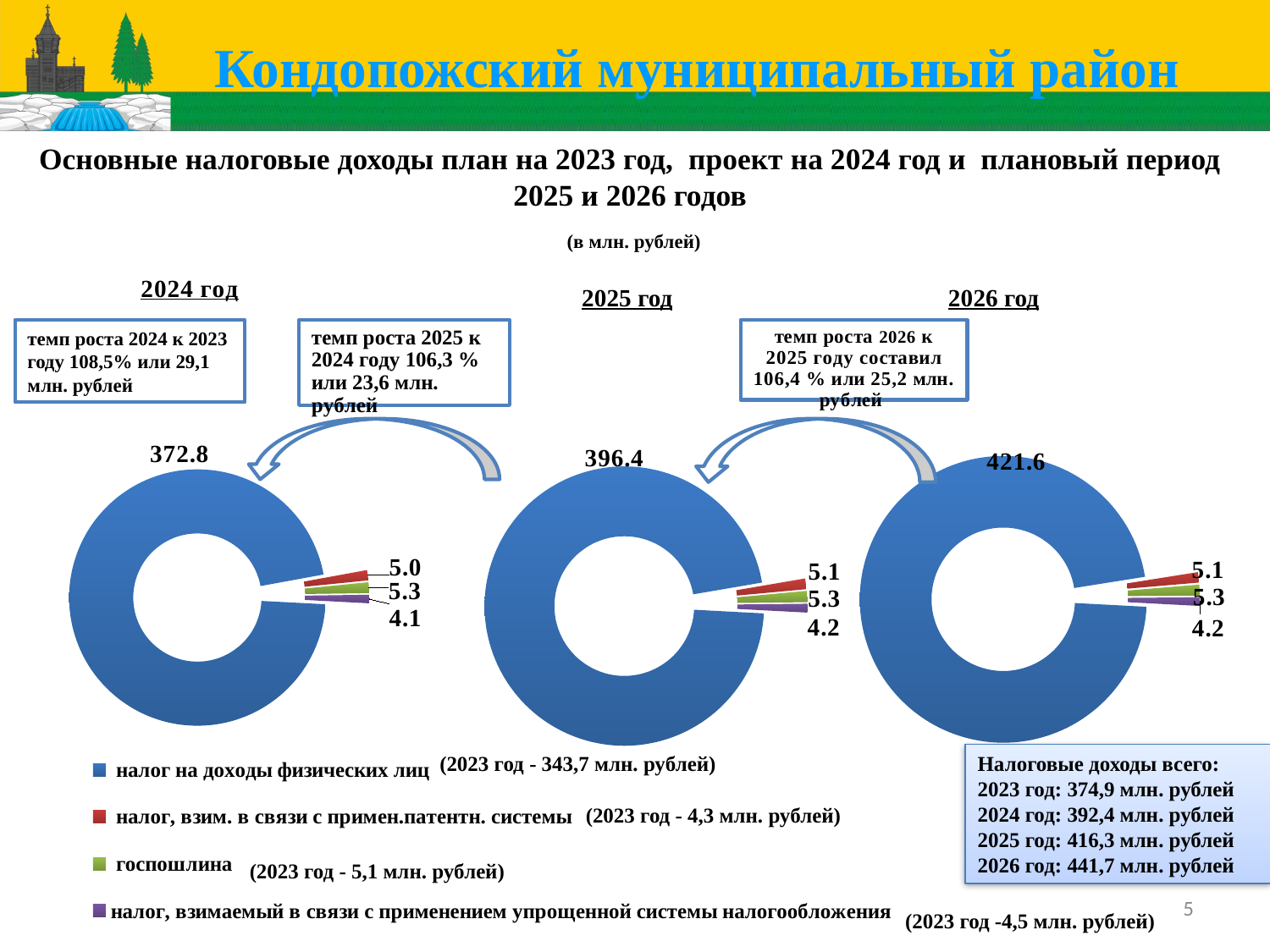
What is the difference between the налог на доходы физических лиц value in the 2026 год chart and in the 2025 год chart? 25.2 In the 2026 год chart, which category has the largest value? налог на доходы физических лиц What is the difference between the налог на доходы физических лиц value in the 2025 год chart and in the 2024 год chart? 23.6 In the 2024 год chart, which category has the smallest value? налог, взимаемый в связи с применением упрощенной системы налогообложения In the 2024 год chart, which is larger: госпошлина or налог, взим. в связи с примен. патентн. системы? госпошлина In the 2025 год chart, what is the value for госпошлина? 5.3 What type of chart is used for the 2024 год, 2025 год and 2026 год data? pie (doughnut) chart In the 2026 год chart, what is the value for налог, взимаемый в связи с применением упрощенной системы налогообложения? 4.2 How many categories (slices) does the 2025 год chart contain? 4 How many entries does the legend list? 4 In the 2024 год chart, what is the value for налог на доходы физических лиц? 372.8 In the 2025 год chart, what is the value for налог, взим. в связи с примен. патентн. системы? 5.1